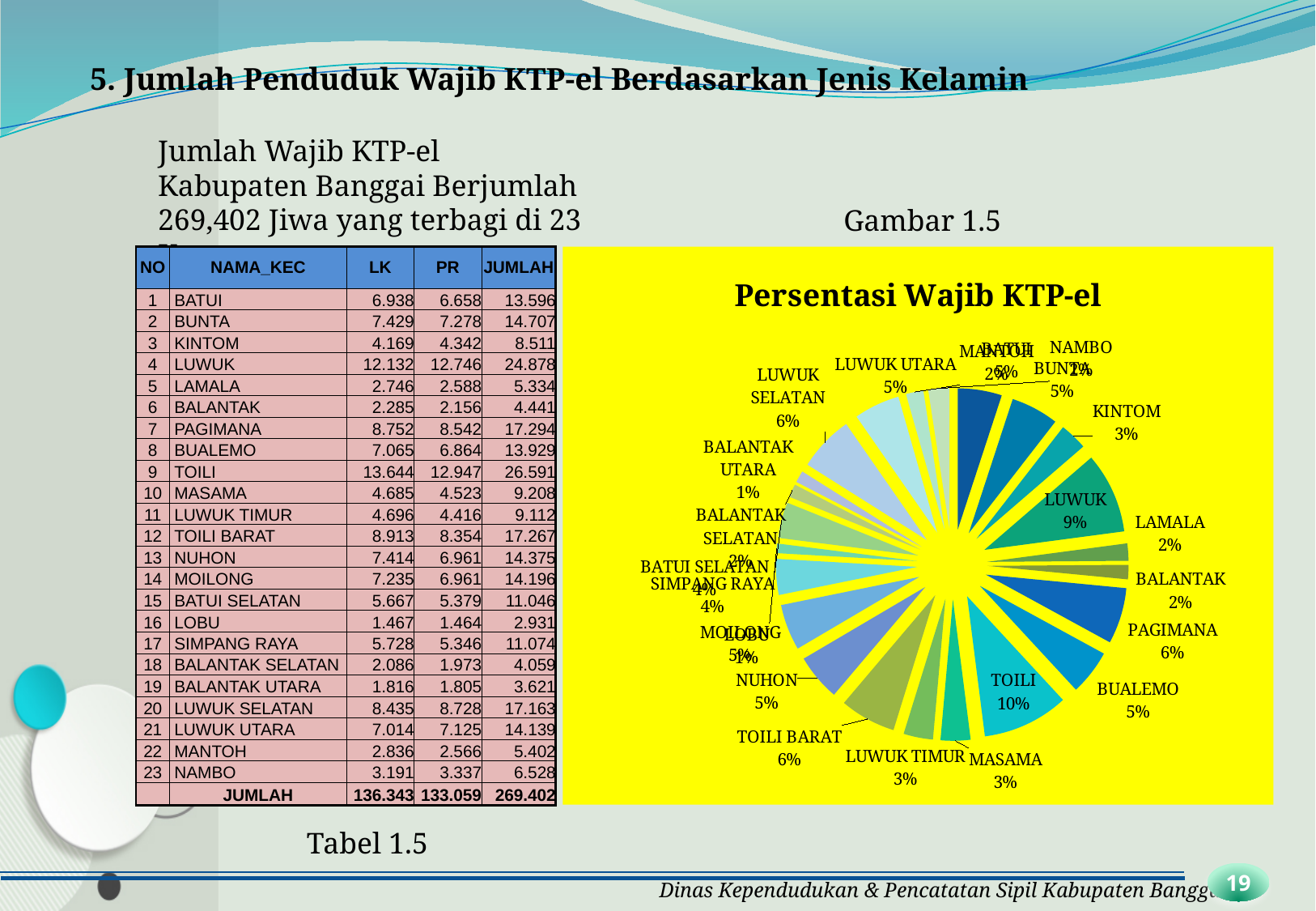
What percentage does the LUWUK slice show in the pie chart? 9% What is the difference in percentage points between the TOILI slice and the LAMALA slice? 8 What percentage does the LUWUK SELATAN slice show in the pie chart? 6% What percentage does the BALANTAK UTARA slice show in the pie chart? 1% What percentage does the KINTOM slice show in the pie chart? 3% What kind of chart is shown on the slide? pie chart What percentage does the TOILI slice show in the pie chart? 10% What is the title of the pie chart? Persentasi Wajib KTP-el Which category has the largest share in the pie chart? TOILI What is the difference in percentage points between the LUWUK slice and the BUALEMO slice? 4 What percentage does the PAGIMANA slice show in the pie chart? 6% Which is larger in the pie chart, the share for LUWUK or the share for NUHON? LUWUK